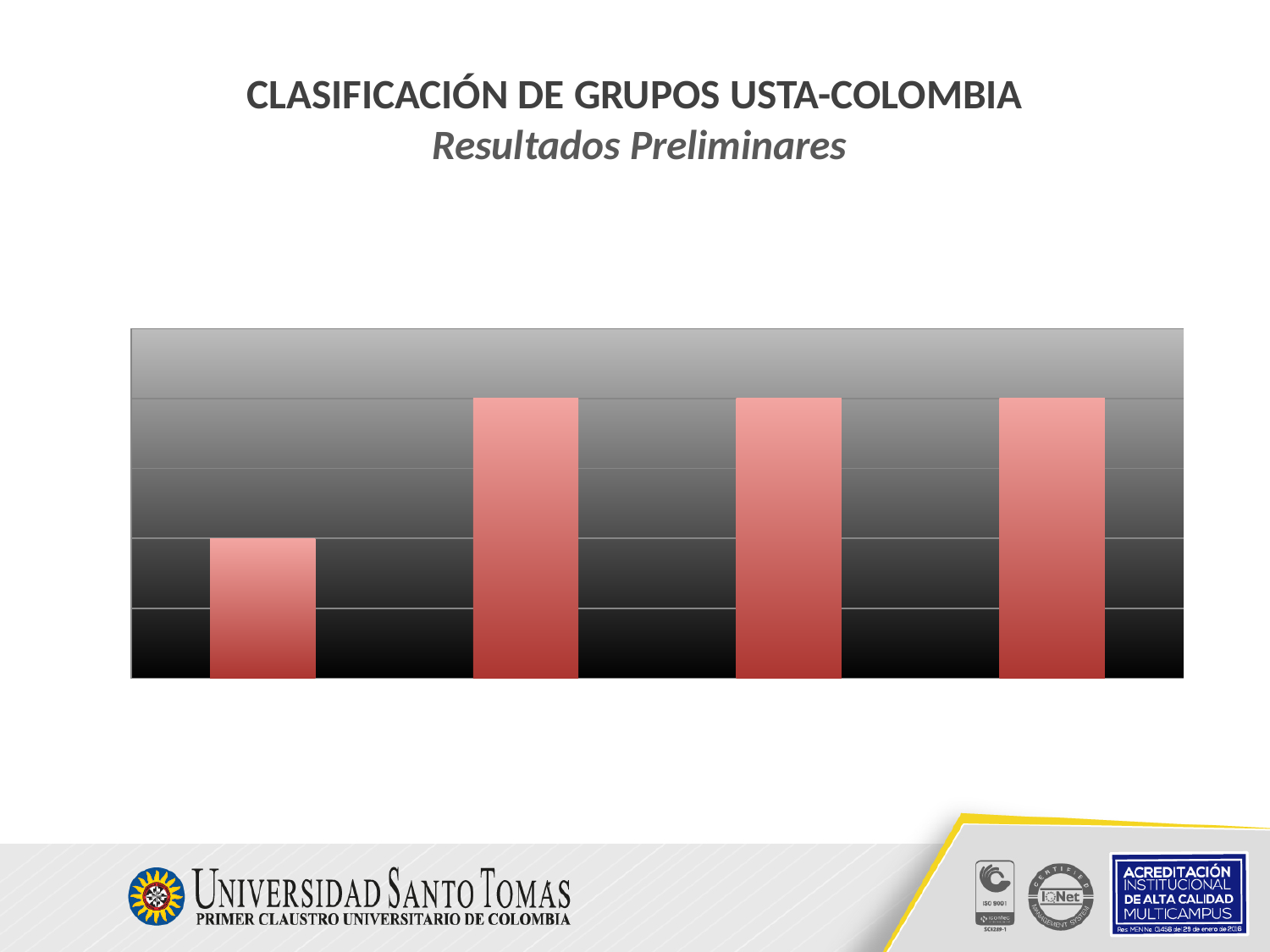
Is the fourth (rightmost) bar taller or shorter than the first (leftmost) bar? taller Is the first (leftmost) bar taller or shorter than the second bar? shorter What colour are the bars in the chart? red Which bar in the chart is the shortest? the first (leftmost) bar How many bars does the chart contain? 4 What kind of chart is shown on the slide? bar chart Does the chart display a legend? No